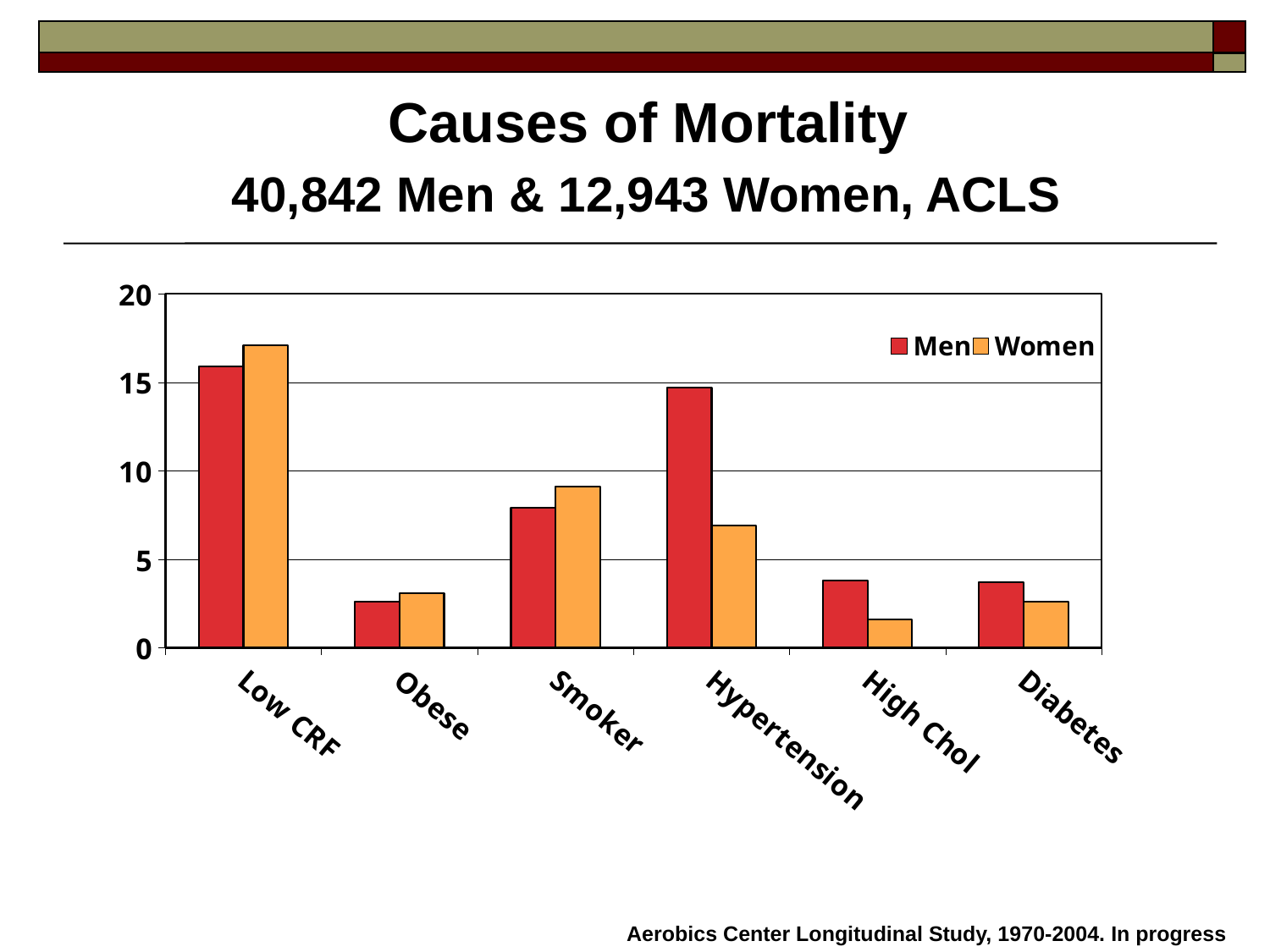
Which category has the highest value for Men? Low CRF Which colour represents the Women series in the chart? orange Is the value for Women in the Hypertension category greater or less than 5? greater Which category has the highest value for Women? Low CRF What kind of chart is shown on the slide? bar chart How many series does the legend list? 2 How many categories are shown on the x axis of the chart? 6 For Low CRF, which series has the larger value, Men or Women? Women For Hypertension, which series has the larger value, Men or Women? Men Is the value for Men in the Low CRF category greater or less than 15? greater Which category has the lowest value for Women? High Chol Is the value for Women in the High Chol category greater or less than 5? less